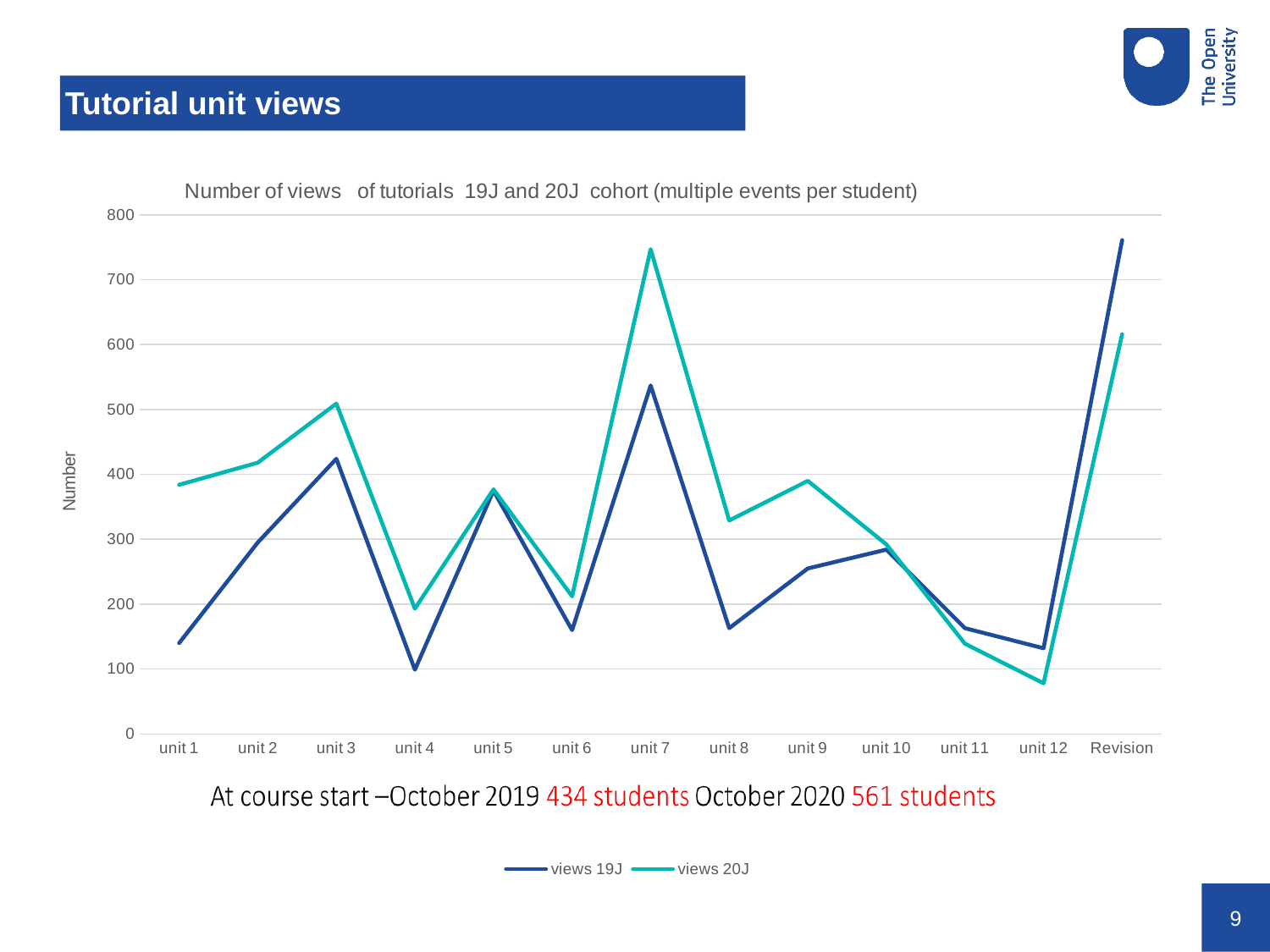
How many series does the legend list? 2 For the views 19J series, which category has the highest value? Revision How many categories are plotted along the x axis? 13 At Revision, which series has the larger value, views 19J or views 20J? views 19J What kind of chart is shown on the slide? line chart For the views 20J series, which category has the lowest value? unit 12 At unit 1, which series has the larger value, views 19J or views 20J? views 20J For the views 20J series, which category has the highest value? unit 7 For the views 19J series, which category has the lowest value? unit 4 Is the views 19J value for unit 4 greater or less than 200? less Do the views 20J values rise or fall from unit 10 to unit 12? fall Is the views 20J value for unit 7 greater or less than 700? greater